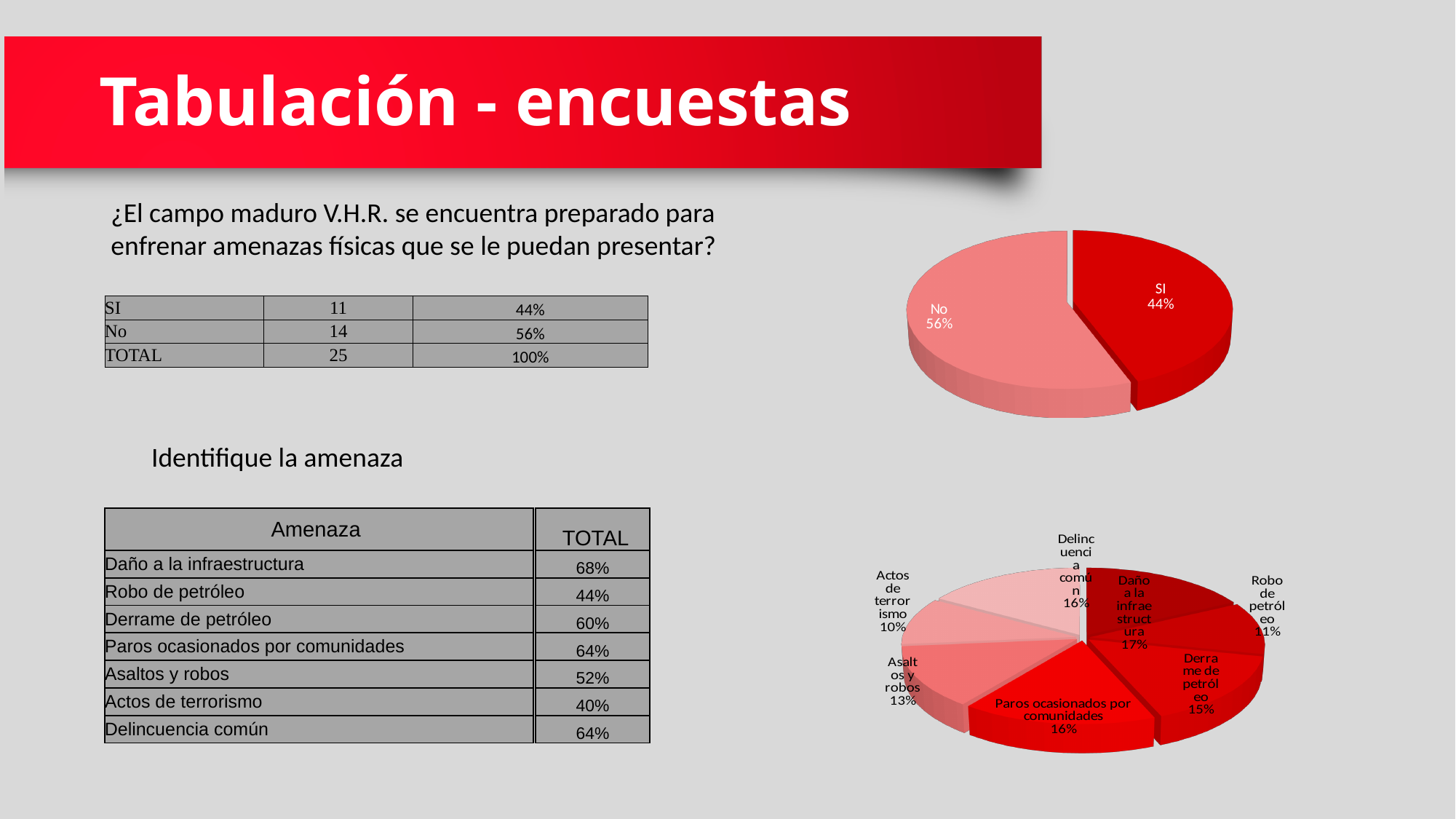
In the bottom-right pie chart, what share does 'Robo de petróleo' have? 11% In the bottom-right pie chart, what is the difference between the shares of 'Derrame de petróleo' and 'Asaltos y robos'? 2% In the bottom-right pie chart, what share does 'Daño a la infraestructura' have? 17% What kind of chart is the top-right chart on the slide? Pie chart How many slices does the bottom-right pie chart have? 7 In the bottom-right pie chart, which slice has the largest share? Daño a la infraestructura In the bottom-right pie chart, which slice has the smallest share? Actos de terrorismo How many slices does the top-right pie chart have? 2 In the top-right pie chart, what share does the 'No' slice have? 56% In the top-right pie chart, what is the difference between the 'No' share and the 'SI' share? 12% In the top-right pie chart, which slice is larger, 'SI' or 'No'? No